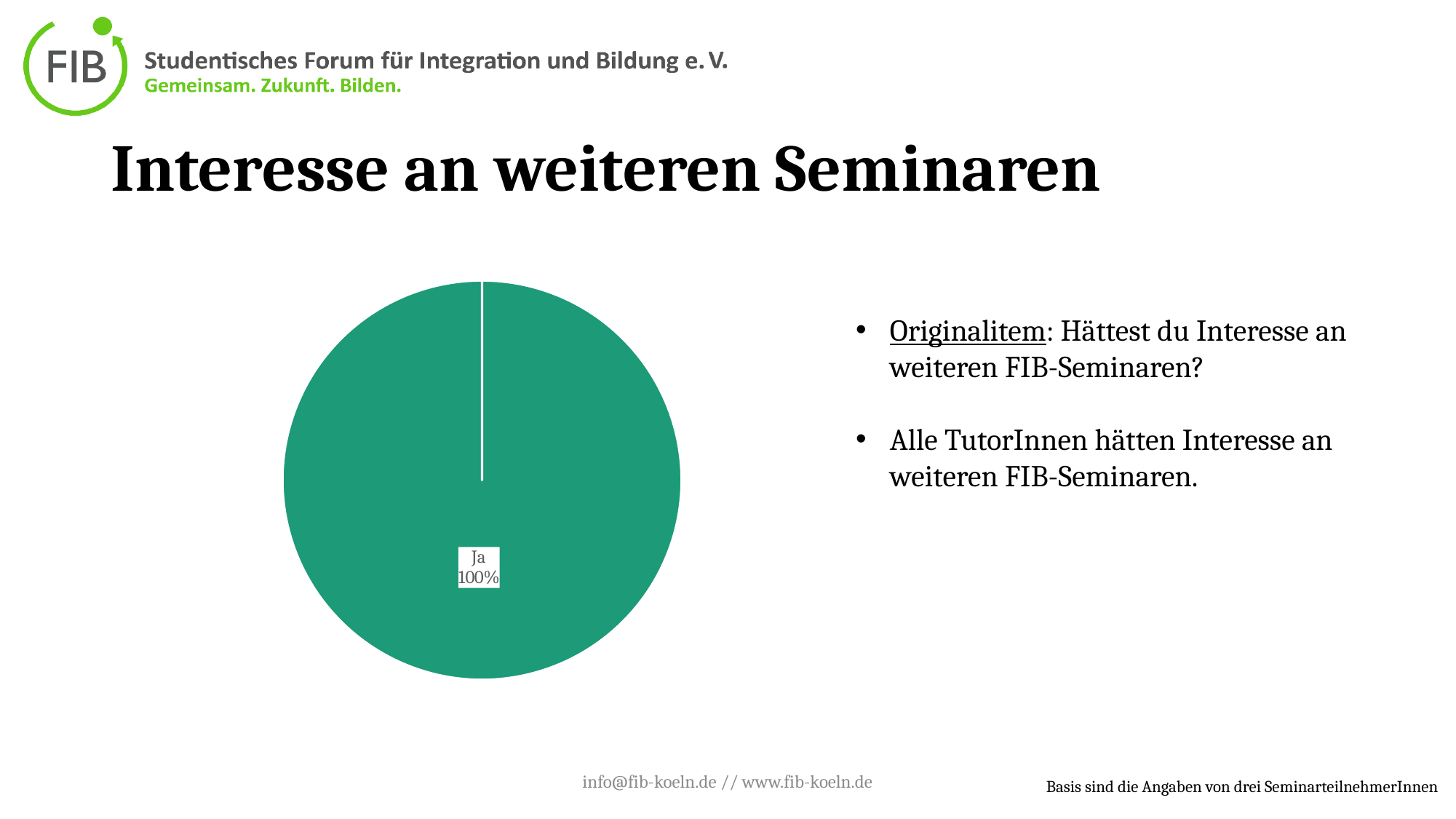
What kind of chart is shown on the slide? pie chart What share of the pie does the "Ja" slice represent? 100% How many slices does the pie chart have? 1 What is the label of the only slice in the pie chart? Ja What colour is the "Ja" slice of the pie chart? green What is the title of the slide containing the pie chart? Interesse an weiteren Seminaren Is the value for "Ja" greater or less than 50%? greater